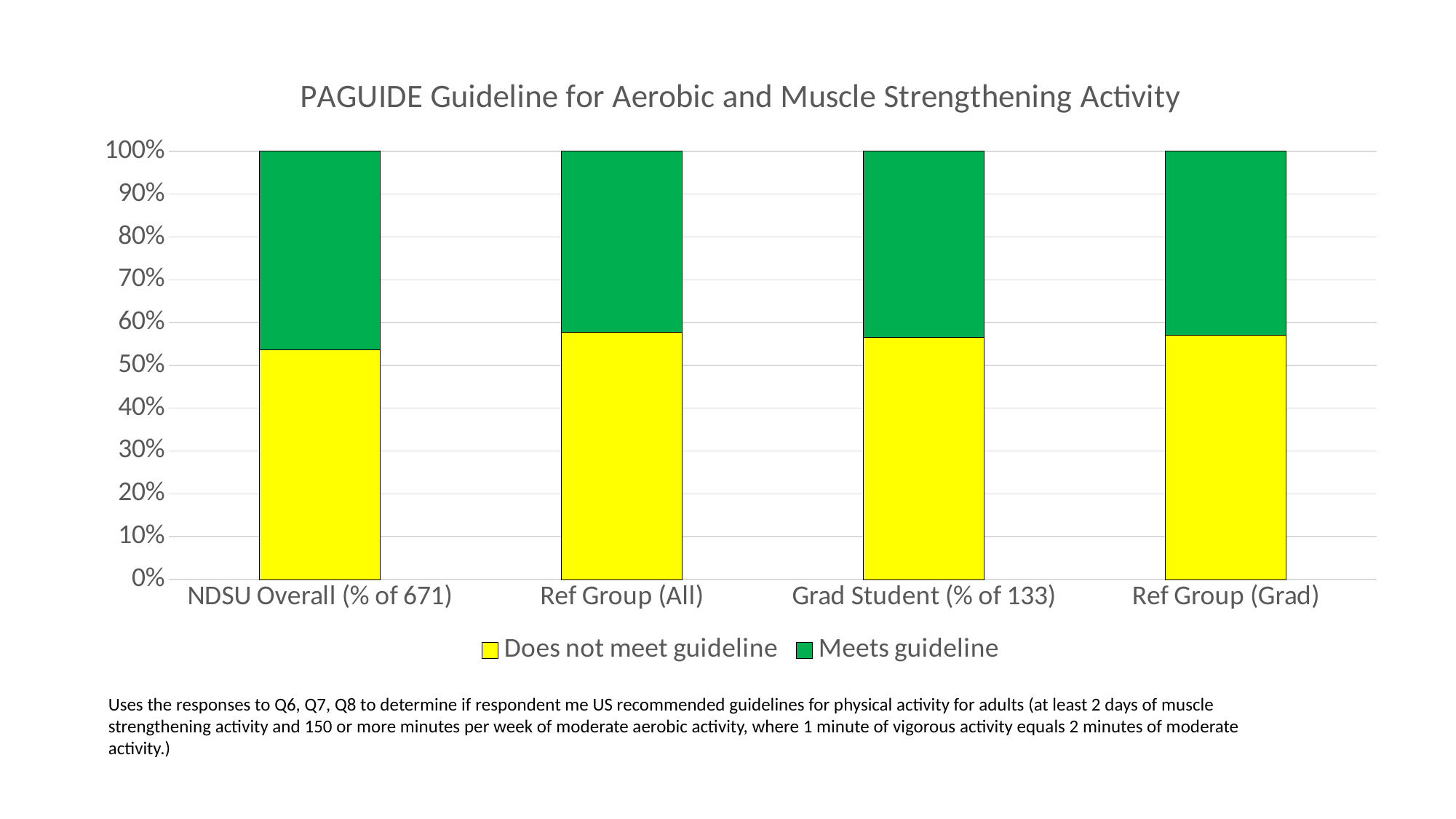
Is the 'Does not meet guideline' value for NDSU Overall (% of 671) greater or less than 50%? greater How many series does the legend list? 2 Which category has the lowest 'Does not meet guideline' share? NDSU Overall (% of 671) What is the total height of the stacked bar for Ref Group (All)? 100% Which colour represents the 'Meets guideline' series? green Which category has the highest 'Meets guideline' share? NDSU Overall (% of 671) Is the 'Meets guideline' value for Grad Student (% of 133) greater or less than 50%? less How many categories are shown on the x axis? 4 Is the 'Does not meet guideline' value for Ref Group (Grad) greater or less than 50%? greater What kind of chart is shown on the slide? stacked bar chart What is the title of the chart? PAGUIDE Guideline for Aerobic and Muscle Strengthening Activity